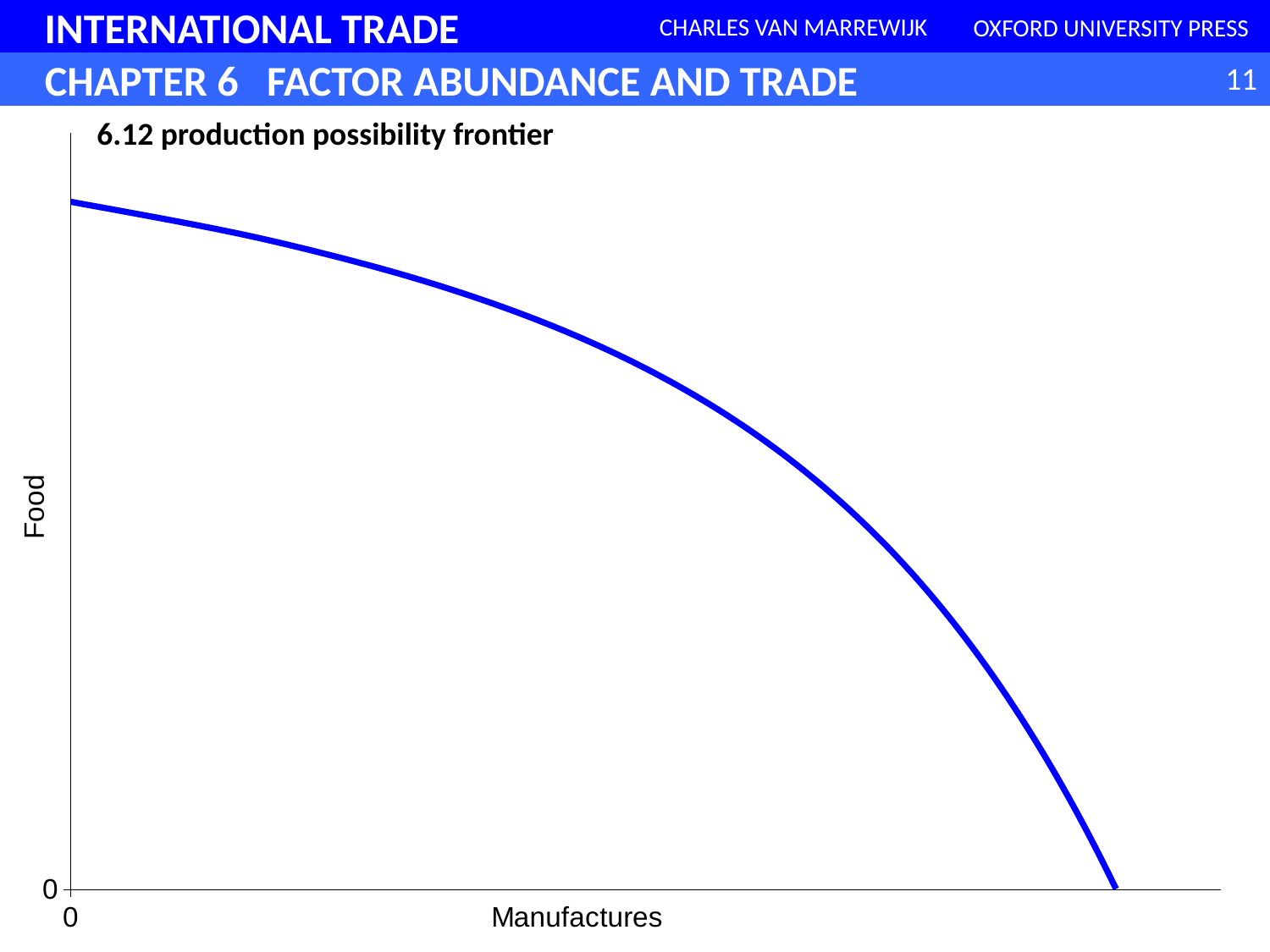
Is the value of Food at the left end of the curve greater or less than 0? greater What is the label on the vertical axis of the chart? Food Does the curve rise or fall as Manufactures increases along the x axis? fall What kind of chart is shown on the slide? line chart Is Food higher at the left end of the curve or at the right end? left end How many lines are plotted on the chart? 1 What is the title of the chart? 6.12 production possibility frontier What value is marked at the origin of the horizontal axis? 0